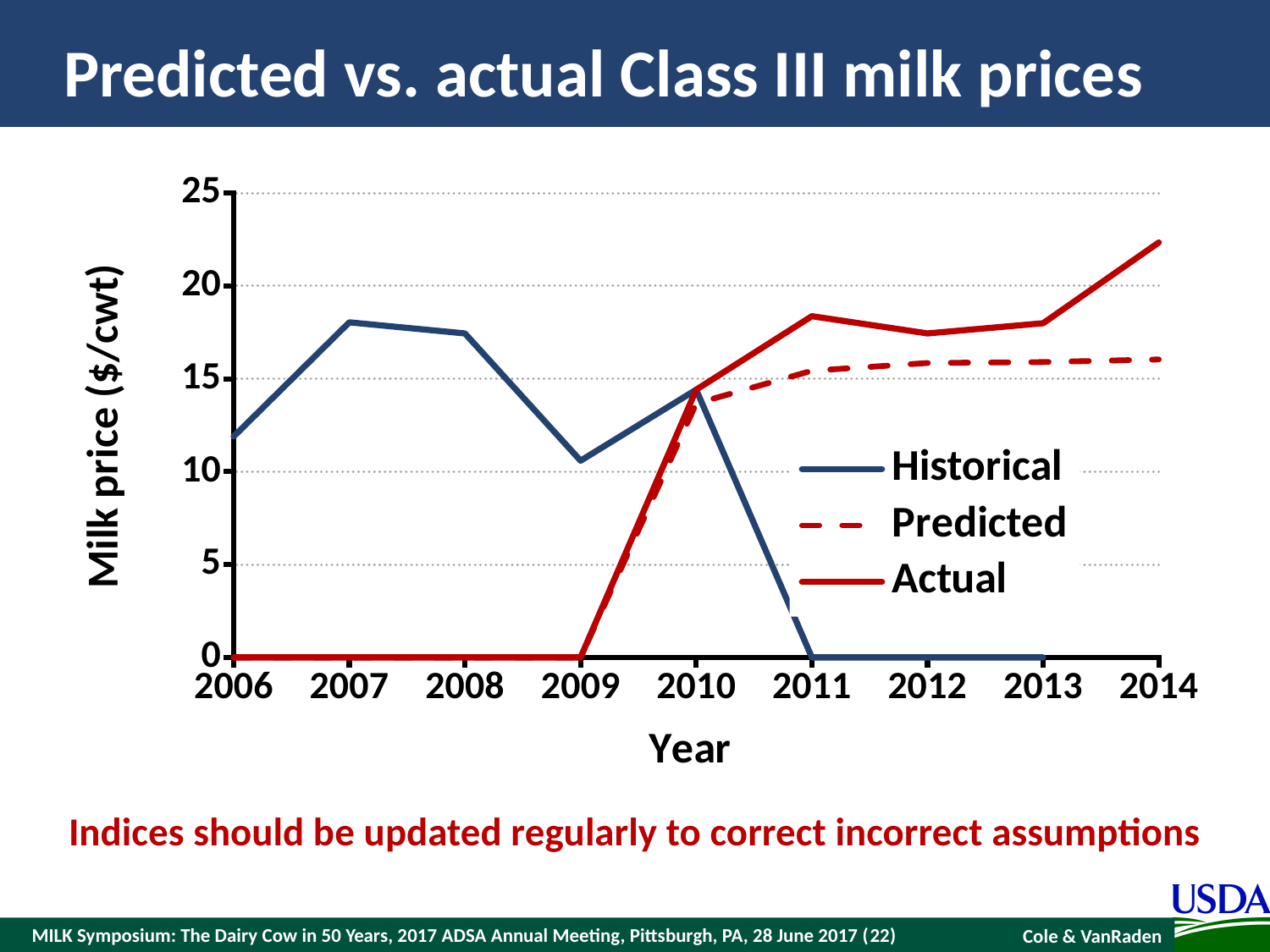
In which year does the Actual series reach its highest value? 2014 What is the label of the y axis of the chart? Milk price ($/cwt) In 2014, which series has the larger value, Actual or Predicted? Actual What kind of chart is shown on the slide? line chart How many years are marked along the x axis of the chart? 9 Is the Actual milk price for 2014 greater or less than 20? greater Does the Predicted series rise or fall from 2010 to 2014? rise Which series in the legend is drawn with a dashed line? Predicted What is the Actual milk price value shown for 2008? 0 How many series does the chart legend list? 3 What is the Historical milk price value shown for 2012? 0 Is the Historical milk price for 2007 greater or less than 15? greater